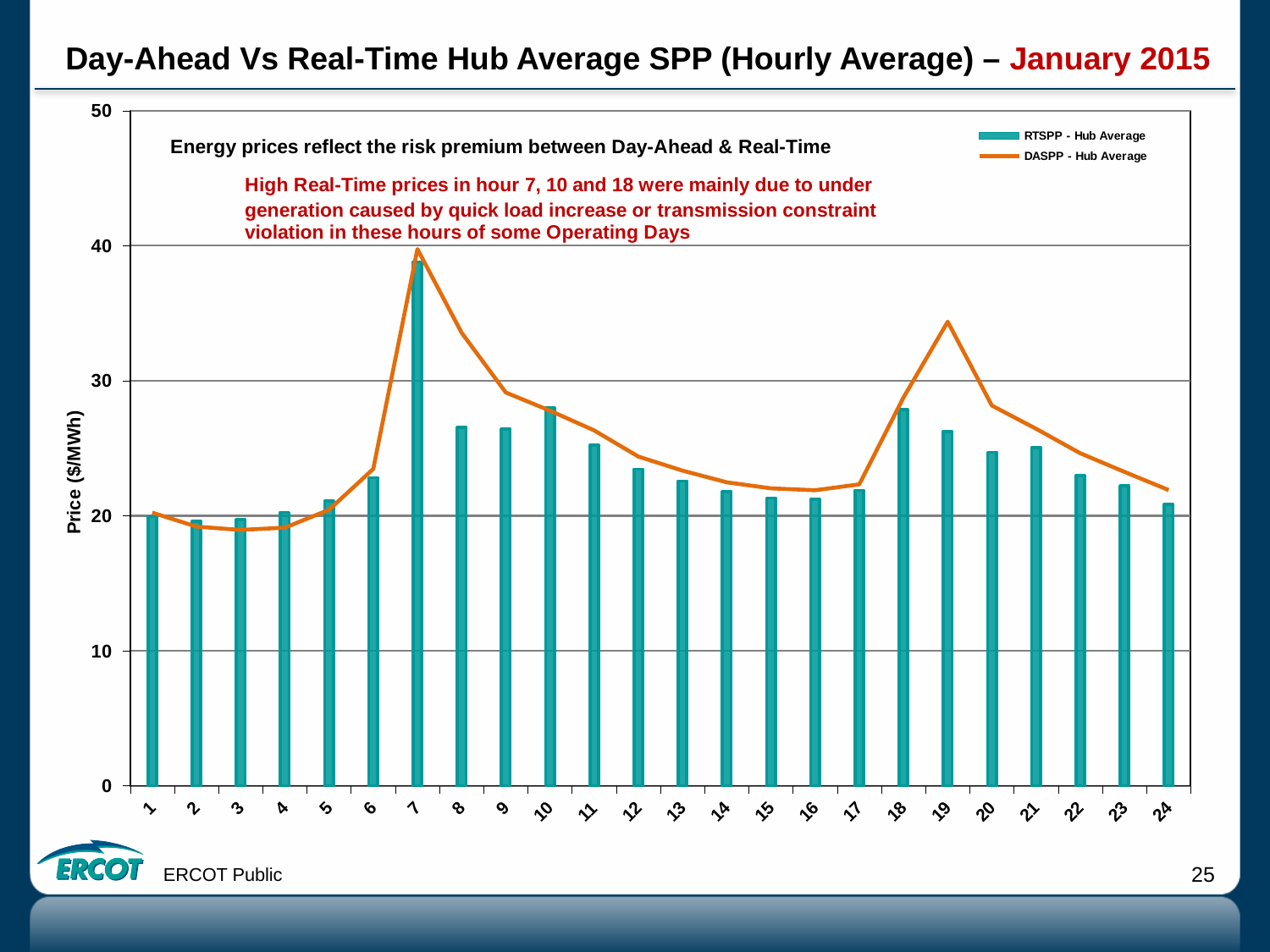
Which series is drawn as an orange line in the chart? DASPP - Hub Average How many series does the chart legend list? 2 Is the RTSPP - Hub Average value for hour 19 greater or less than 30? less Which hour has the highest DASPP - Hub Average value? 7 What kind of chart is shown on the slide? A combined bar and line chart Is the RTSPP - Hub Average value for hour 7 greater or less than 30? greater Which hour has the highest RTSPP - Hub Average bar? 7 Do the RTSPP - Hub Average bars rise or fall from hour 7 to hour 17? fall How many hours (categories) are plotted along the x axis of the chart? 24 Which is larger at hour 19: the DASPP - Hub Average value or the RTSPP - Hub Average value? DASPP - Hub Average Is the DASPP - Hub Average value for hour 19 greater or less than 30? greater